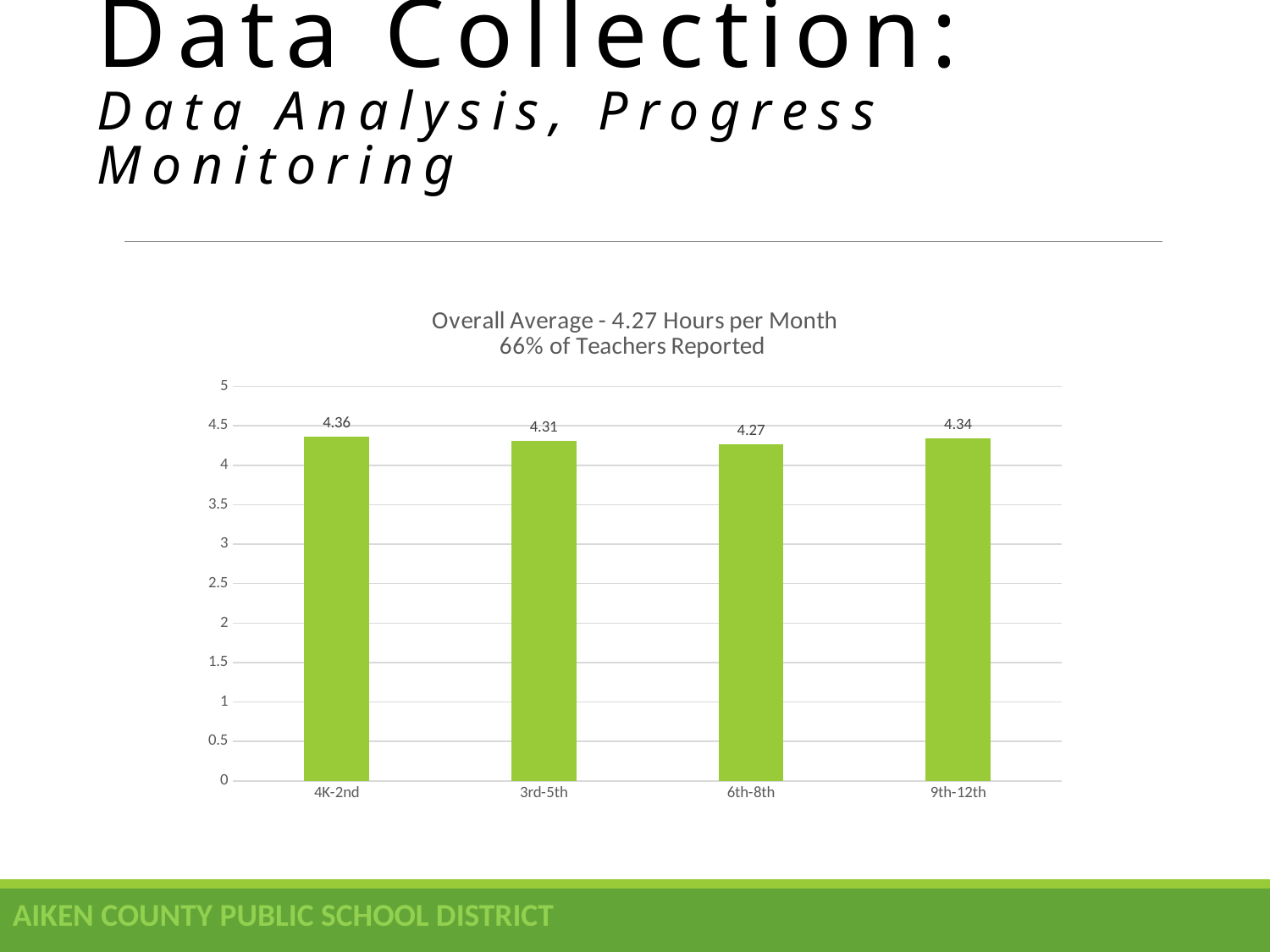
Which grade band has the highest value? 4K-2nd What is the value for 9th-12th? 4.34 What kind of chart is shown on the slide? bar chart Which is larger, the value for 3rd-5th or the value for 9th-12th? 9th-12th Which grade band has the lowest value? 6th-8th What is the value for 3rd-5th? 4.31 What is the difference between the values for 4K-2nd and 6th-8th? 0.09 What is the value for 6th-8th? 4.27 How many grade bands are shown on the chart? 4 Is the value for 6th-8th greater or less than 4? greater What is the value for 4K-2nd? 4.36 According to the chart title, what is the overall average in hours per month? 4.27 Hours per Month